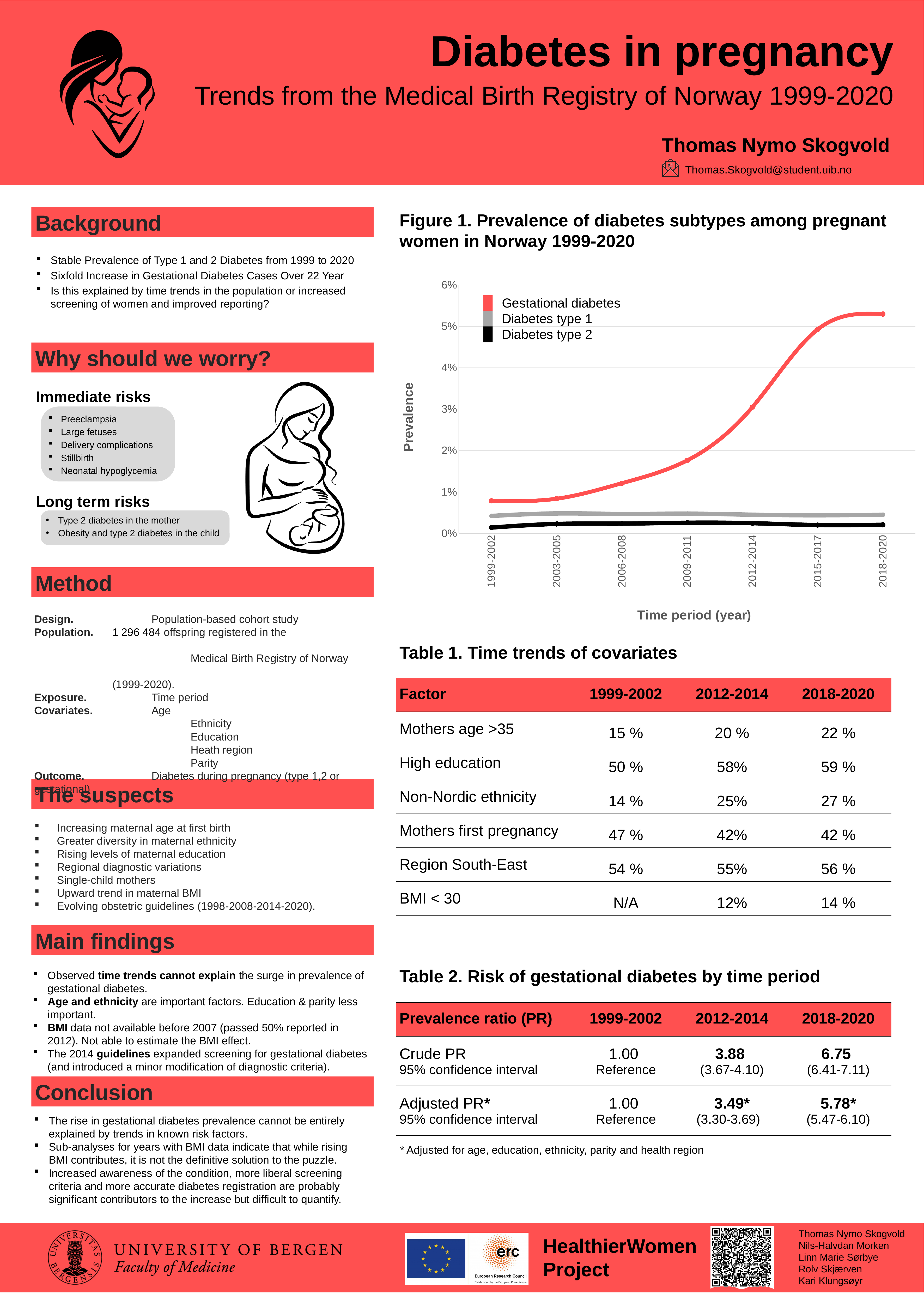
In Figure 1, which diabetes subtype has the highest prevalence in 2018-2020? Gestational diabetes In Figure 1, is the prevalence of gestational diabetes in 1999-2002 greater or less than 1%? less In Figure 1, is the prevalence of gestational diabetes in 2009-2011 greater or less than 2%? less In Figure 1, does the prevalence of gestational diabetes rise or fall from 1999-2002 to 2018-2020? rise What is the label of the y axis in Figure 1? Prevalence In Figure 1, which is higher in 1999-2002: the prevalence of gestational diabetes or of diabetes type 1? Gestational diabetes In Figure 1, which diabetes subtype has the lowest prevalence in 2018-2020? Diabetes type 2 How many series does the legend of Figure 1 list? 3 In Figure 1, is the prevalence of gestational diabetes in 2018-2020 greater or less than 5%? greater How many time periods are shown on the x axis of Figure 1? 7 What kind of chart is Figure 1? line chart In Figure 1, which colour represents diabetes type 1? grey